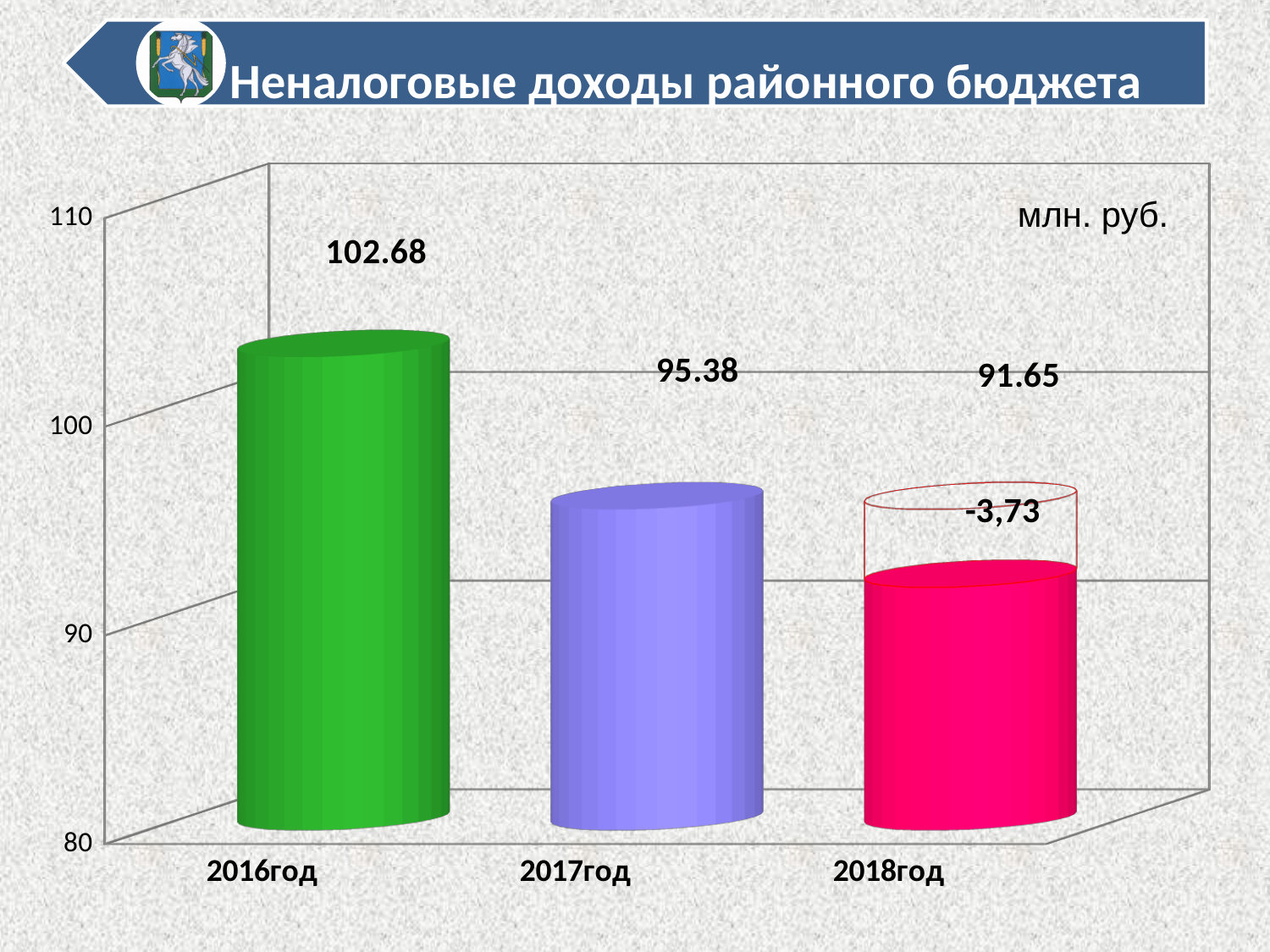
Is the value for 2016год greater or less than 100? greater What is the value for 2018год? 91.65 Which year has the lowest value? 2018год What is the value for 2017год? 95.38 Do the values rise or fall from 2016год to 2018год? fall How many years are shown on the chart? 3 What is the value for 2016год? 102.68 Which is larger, the value for 2017год or the value for 2018год? 2017год What kind of chart is shown on the slide? bar chart What is the difference between the values for 2017год and 2018год? 3.73 Which year has the highest value? 2016год What is the difference between the values for 2016год and 2017год? 7.30